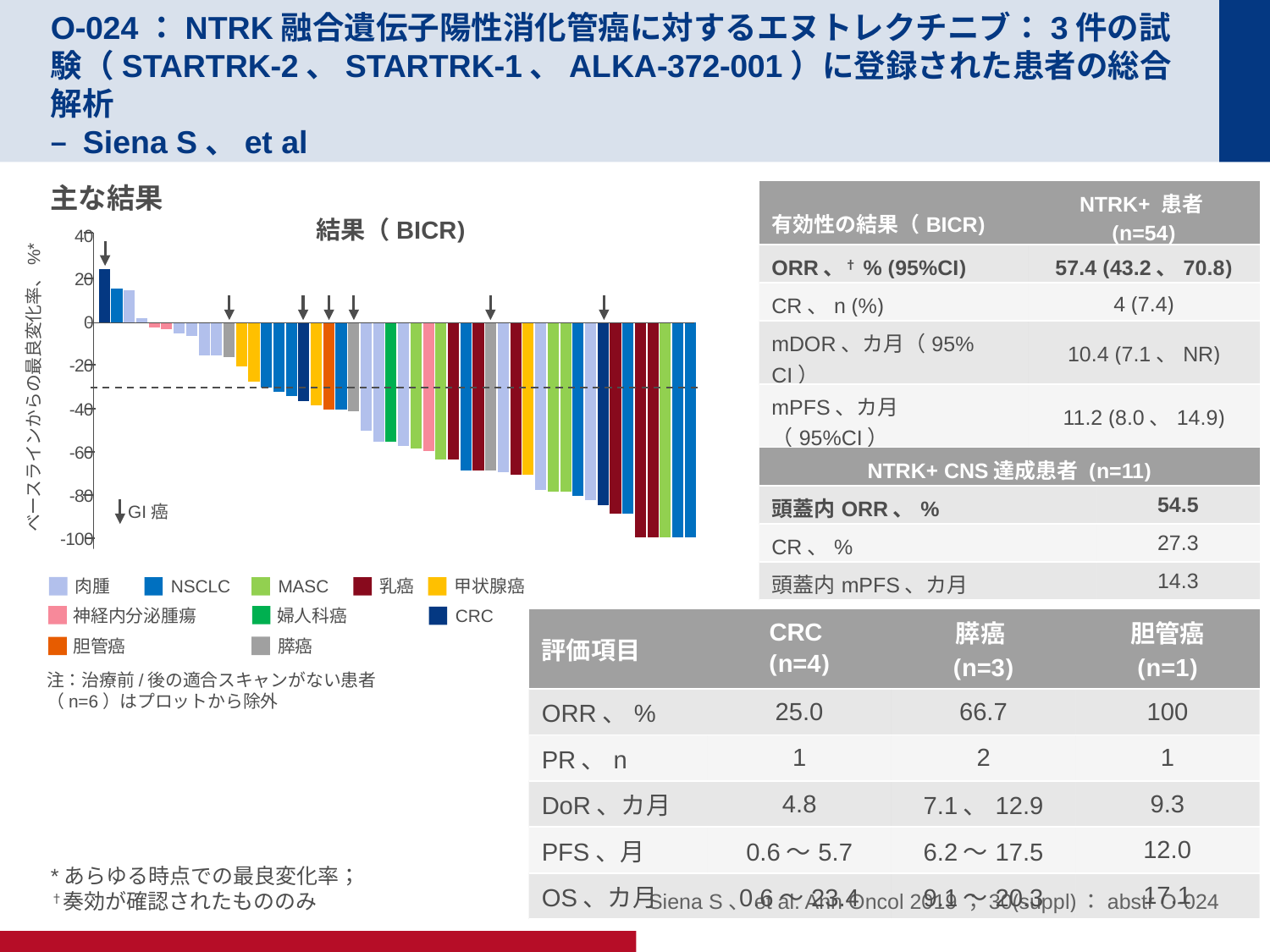
What is the highest value shown on the vertical axis of the 結果（BICR) chart? 40 What is the label of the vertical axis of the 結果（BICR) chart? ベースラインからの最良変化率、%* In the 結果（BICR) chart, which bar is larger: the leftmost bar or the rightmost bar? the leftmost bar What is the title of the bar chart on the slide? 結果（BICR) In the 結果（BICR) chart, do the bar values rise or fall moving from left to right along the x axis? fall How many tumour types does the legend of the 結果（BICR) chart list? 10 In the 結果（BICR) chart, is the value of the rightmost bar greater or less than -80? less What kind of chart is shown under the title 結果（BICR)? bar chart What is the lowest value shown on the vertical axis of the 結果（BICR) chart? -100 In the 結果（BICR) chart, is the value of the leftmost bar greater or less than 0? greater